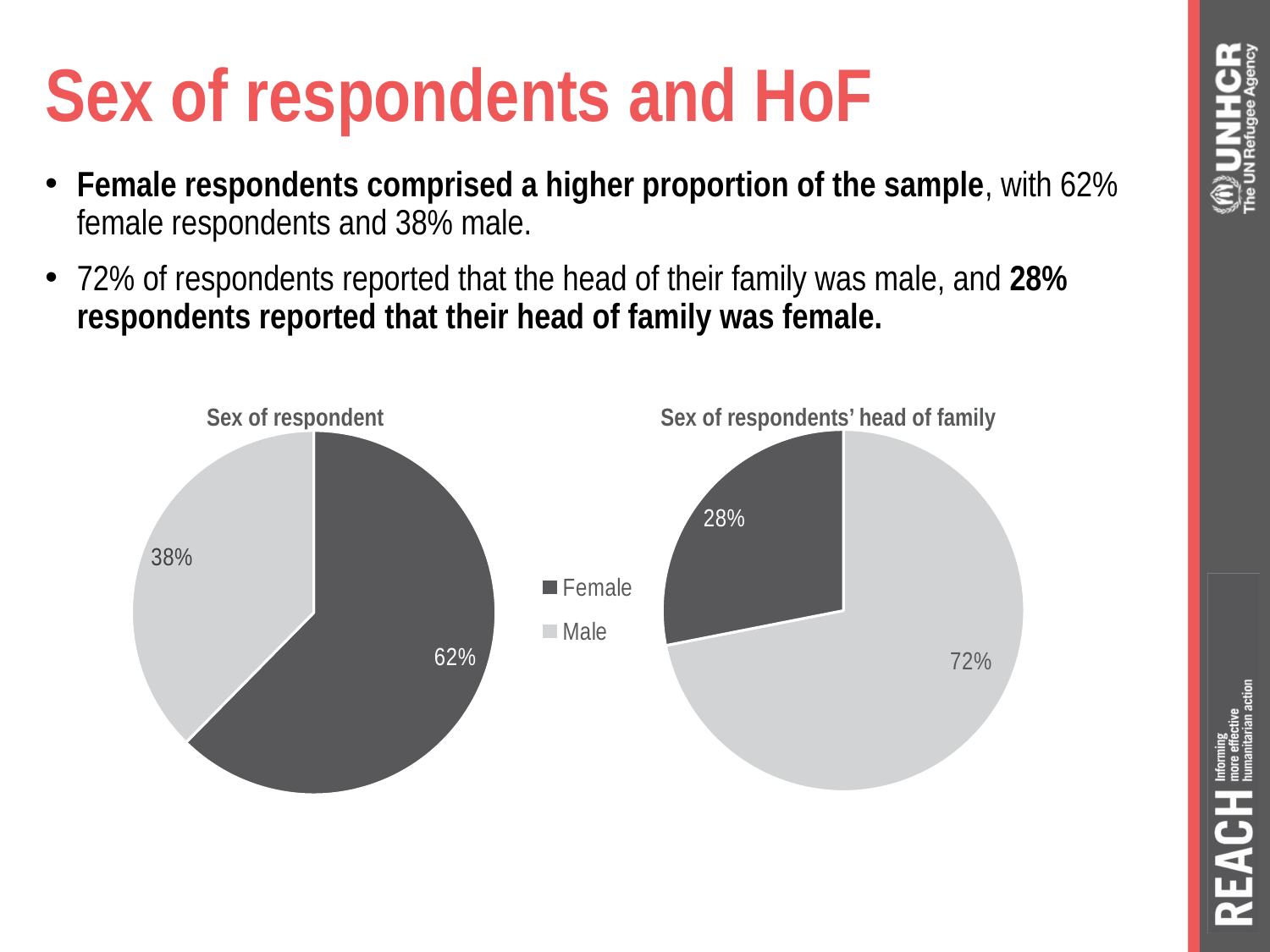
In the 'Sex of respondents' head of family' chart, what share of heads of family were male? 72% How many categories does the legend list for the pie charts? 2 In the 'Sex of respondent' chart, what share of respondents were male? 38% In the 'Sex of respondents' head of family' chart, what share of heads of family were female? 28% In the 'Sex of respondent' chart, what share of respondents were female? 62% In the 'Sex of respondents' head of family' chart, is the male slice larger or smaller than the female slice? larger In the 'Sex of respondents' head of family' chart, which category has the smallest slice? Female In the 'Sex of respondents' head of family' chart, what is the difference between the male and female shares? 44% In the 'Sex of respondent' chart, what is the difference between the female and male shares? 24% In the 'Sex of respondent' chart, which category has the largest slice? Female What kind of chart is the 'Sex of respondent' chart? pie chart In the legend, which colour represents Female? dark grey